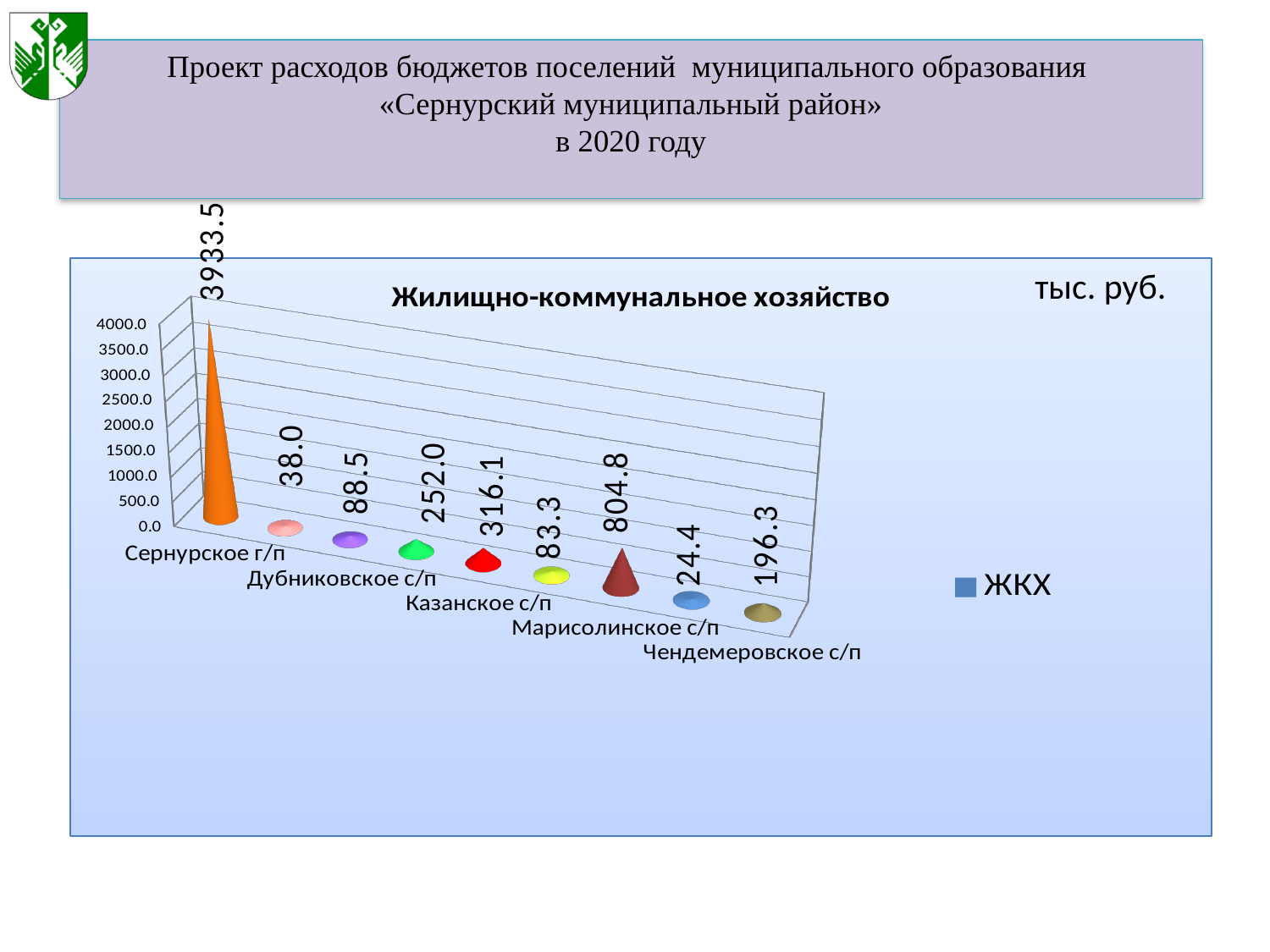
What is the title of the chart? Жилищно-коммунальное хозяйство What is the smallest value shown on the chart? 24.4 What is the value for Казанское с/п? 316.1 Which is larger, the value for Казанское с/п or for Чендемеровское с/п? Казанское с/п What is the difference between the values for Сернурское г/п and Марисолинское с/п? 3128.7 What is the value for Сернурское г/п? 3933.5 How many series does the legend list? 1 What kind of chart is shown? bar chart What is the value for Марисолинское с/п? 804.8 How many data points are plotted on the chart? 9 Which category has the highest value? Сернурское г/п What is the value for Чендемеровское с/п? 196.3